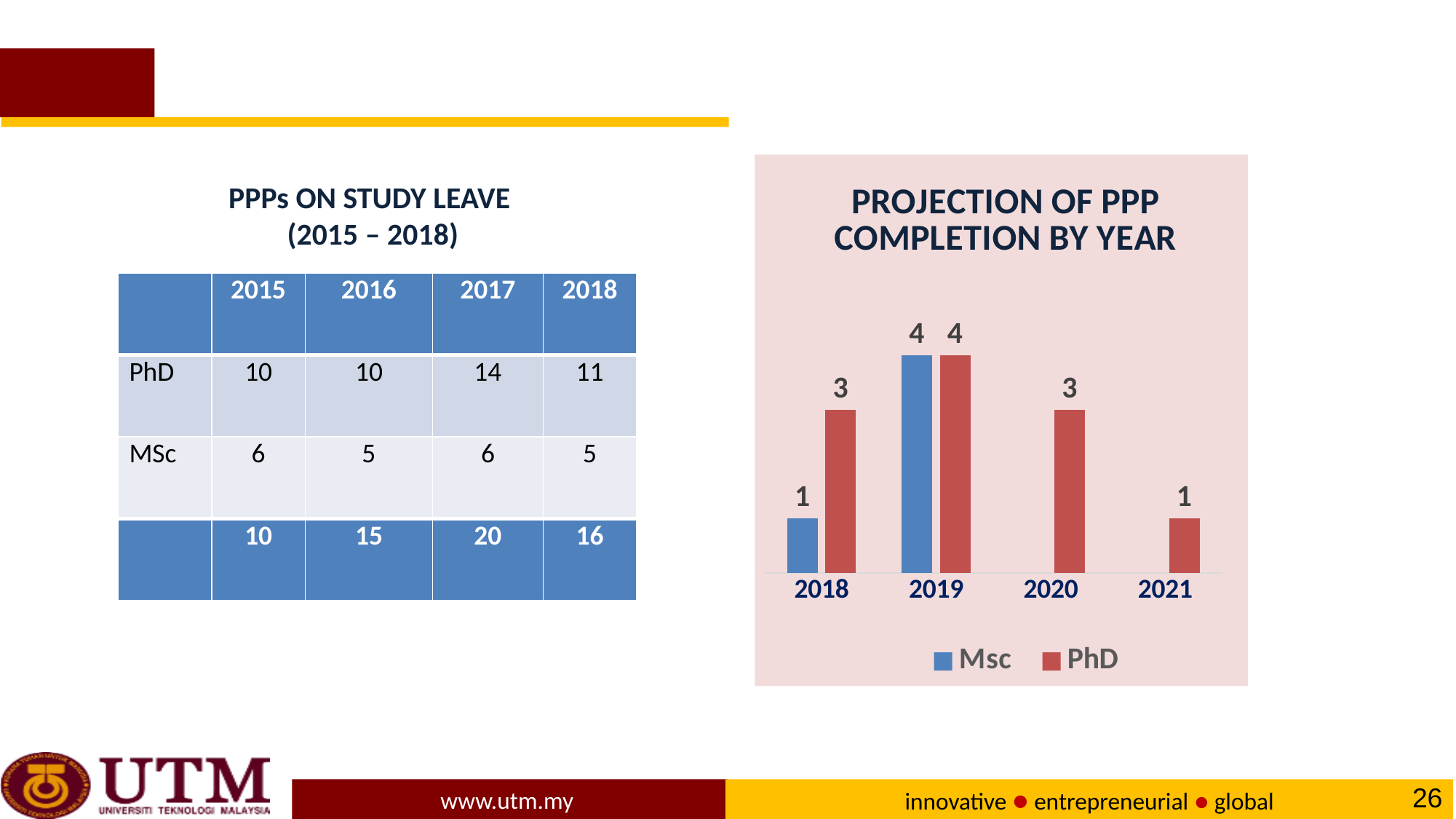
In the chart titled "Projection of PPP Completion by Year", what is the PhD value for 2021? 1 In the chart titled "Projection of PPP Completion by Year", which year has the lowest PhD value? 2021 In the chart titled "Projection of PPP Completion by Year", which year has the highest PhD value? 2019 In the chart titled "Projection of PPP Completion by Year", which colour represents the PhD series? red In the chart titled "Projection of PPP Completion by Year", what is the PhD value for 2018? 3 In the chart titled "Projection of PPP Completion by Year", how many series does the legend list? 2 In the chart titled "Projection of PPP Completion by Year", what is the Msc value for 2018? 1 What kind of chart is the "Projection of PPP Completion by Year" chart? bar chart In the chart titled "Projection of PPP Completion by Year", how many years are shown on the x axis? 4 In the chart titled "Projection of PPP Completion by Year", what is the Msc value for 2019? 4 In the chart titled "Projection of PPP Completion by Year", what is the difference between the PhD values for 2018 and 2021? 2 In the chart titled "Projection of PPP Completion by Year", which series has the larger value in 2018, Msc or PhD? PhD